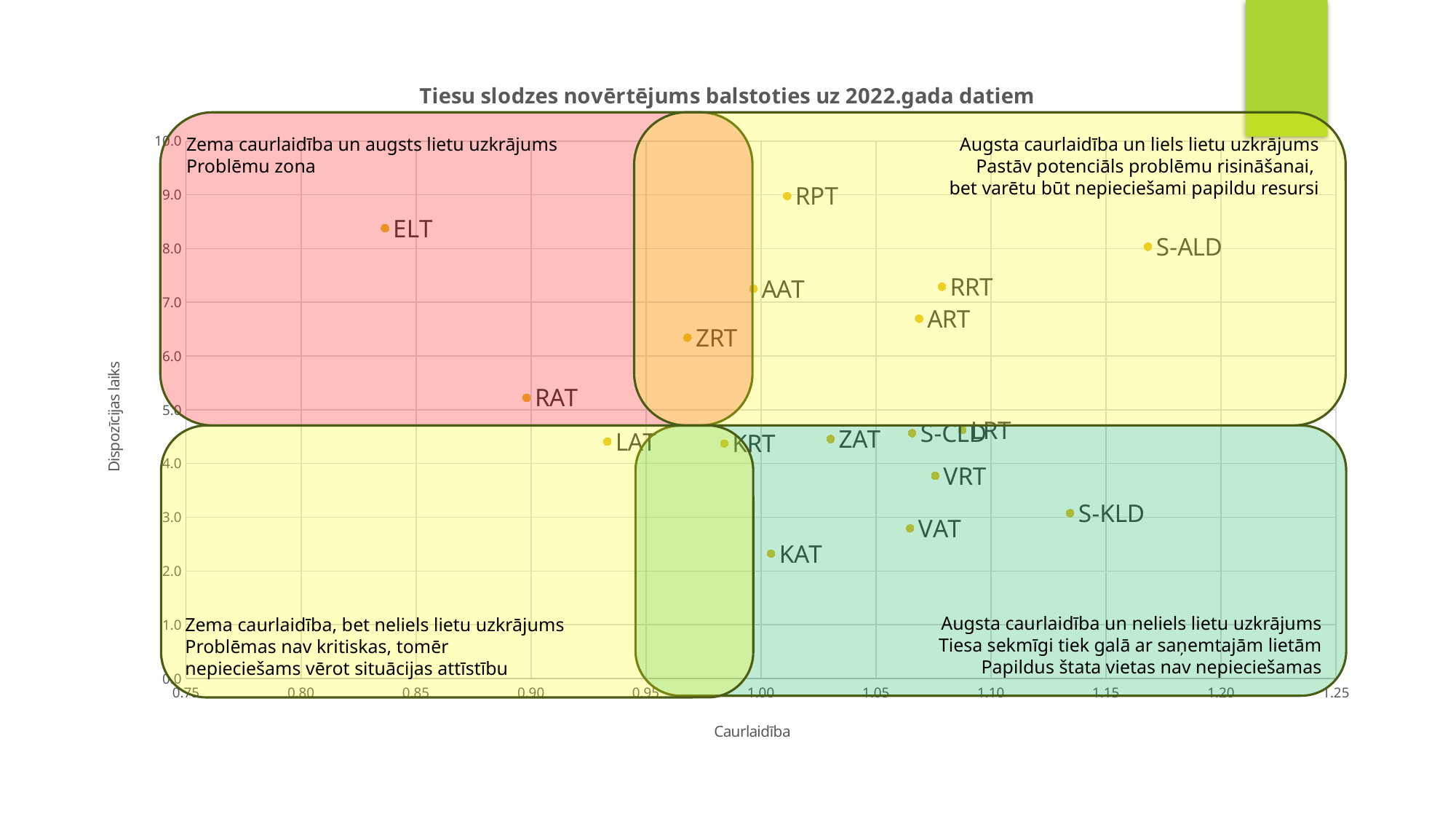
Which point has the highest Caurlaidība value? S-ALD Is the Dispozīcijas laiks value for KAT greater or less than 3.0? less Is the Caurlaidība value for S-KLD greater or less than 1.10? greater How many labelled data points are plotted on the chart? 17 What is the title of the chart? Tiesu slodzes novērtējums balstoties uz 2022.gada datiem Which has the higher Dispozīcijas laiks value, VRT or VAT? VRT Which point has the lowest Dispozīcijas laiks value? KAT What is the label of the horizontal axis? Caurlaidība Is the Caurlaidība value for ELT greater or less than 0.90? less Which point has the highest Dispozīcijas laiks value? RPT Which point has the lowest Caurlaidība value? ELT What kind of chart is shown on the slide? scatter chart